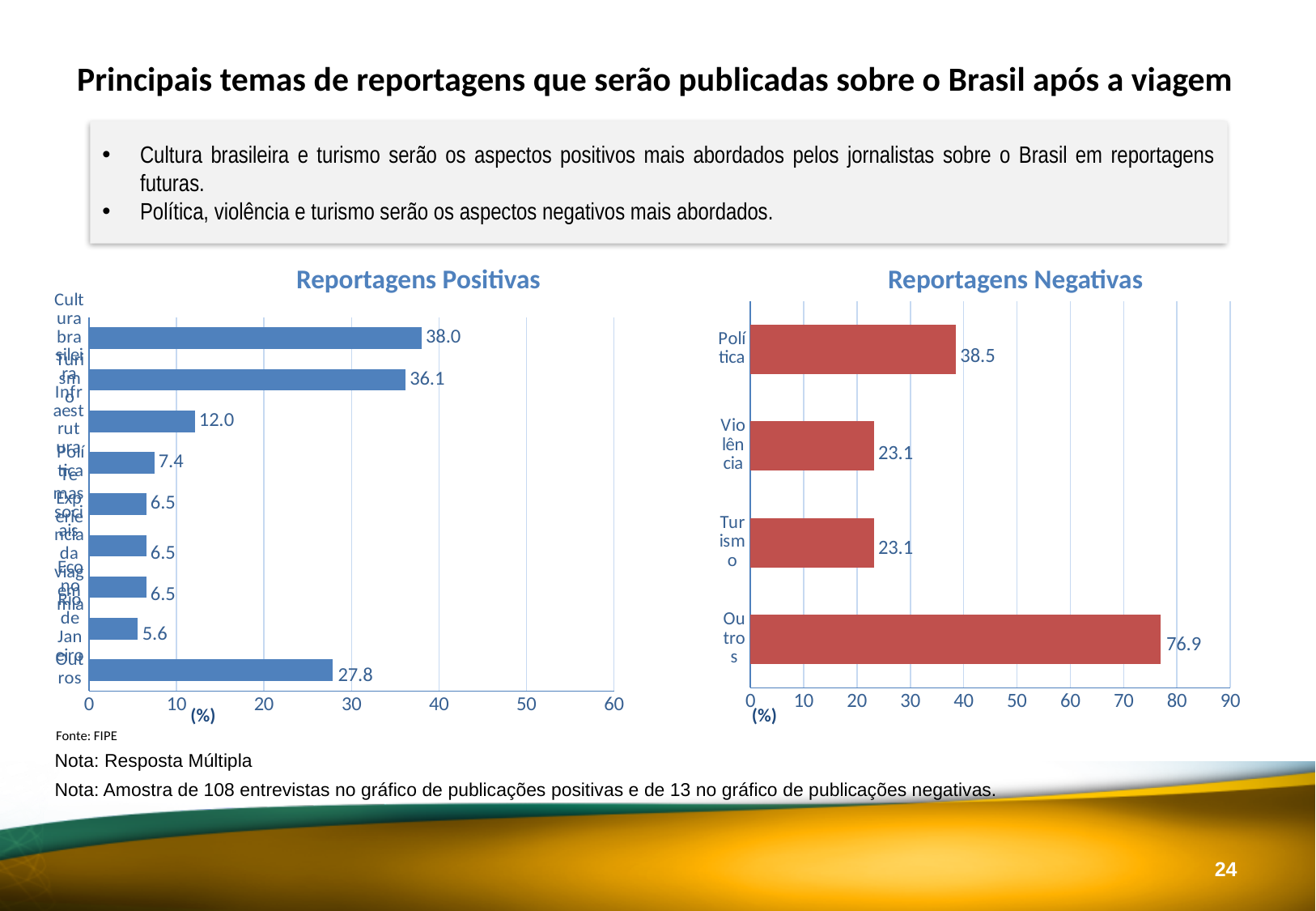
In the Reportagens Negativas chart, which is larger, Política or Violência? Política What type of chart is the Reportagens Positivas chart? Bar chart How many categories are shown in the Reportagens Negativas chart? 4 In the Reportagens Negativas chart, what is the value for Outros? 76.9 How many categories are shown in the Reportagens Positivas chart? 9 In the Reportagens Positivas chart, what is the value for Outros? 27.8 In the Reportagens Negativas chart, what is the value for Política? 38.5 In the Reportagens Negativas chart, what is the difference between the values for Outros and Política? 38.4 In the Reportagens Negativas chart, which category has the highest value? Outros In the Reportagens Positivas chart, what is the value for Cultura brasileira? 38.0 In the Reportagens Positivas chart, what is the value for Turismo? 36.1 In the Reportagens Positivas chart, what is the difference between the values for Cultura brasileira and Turismo? 1.9